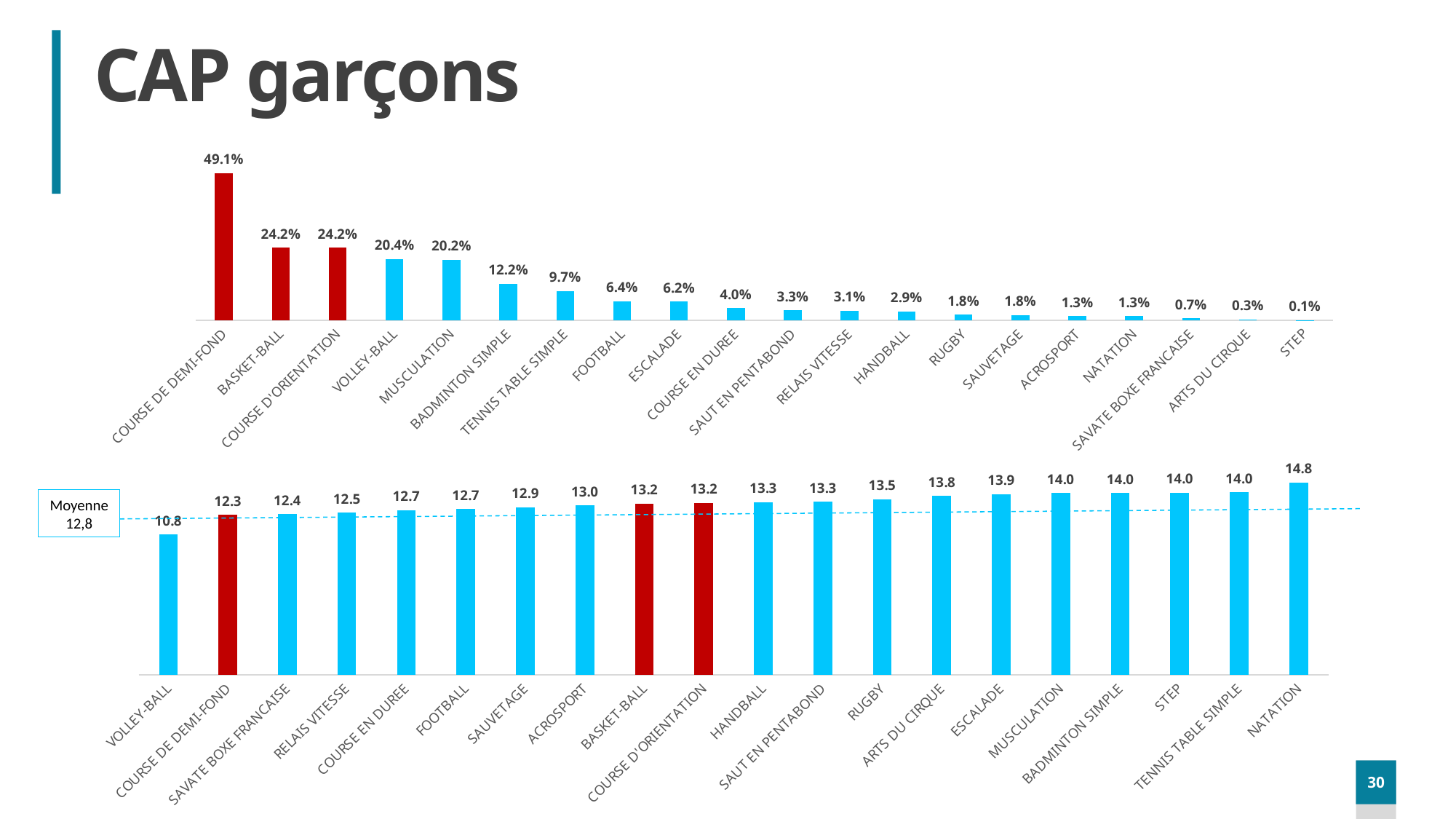
In the top chart, what is the value for COURSE DE DEMI-FOND? 49.1% In the bottom chart, what is the difference between NATATION and VOLLEY-BALL? 4.0 In the top chart, what is the difference between VOLLEY-BALL and MUSCULATION? 0.2% How many categories are shown in the top chart? 20 In the top chart, which category has the lowest value? STEP In the top chart, what is the value for TENNIS TABLE SIMPLE? 9.7% In the bottom chart, what value is given for the 'Moyenne' (average) label? 12,8 What type of chart is the bottom chart? bar chart In the bottom chart, which category has the lowest value? VOLLEY-BALL In the top chart, which is larger, FOOTBALL or ESCALADE? FOOTBALL In the bottom chart, what is the value for NATATION? 14.8 In the bottom chart, do the values rise or fall from left to right? rise